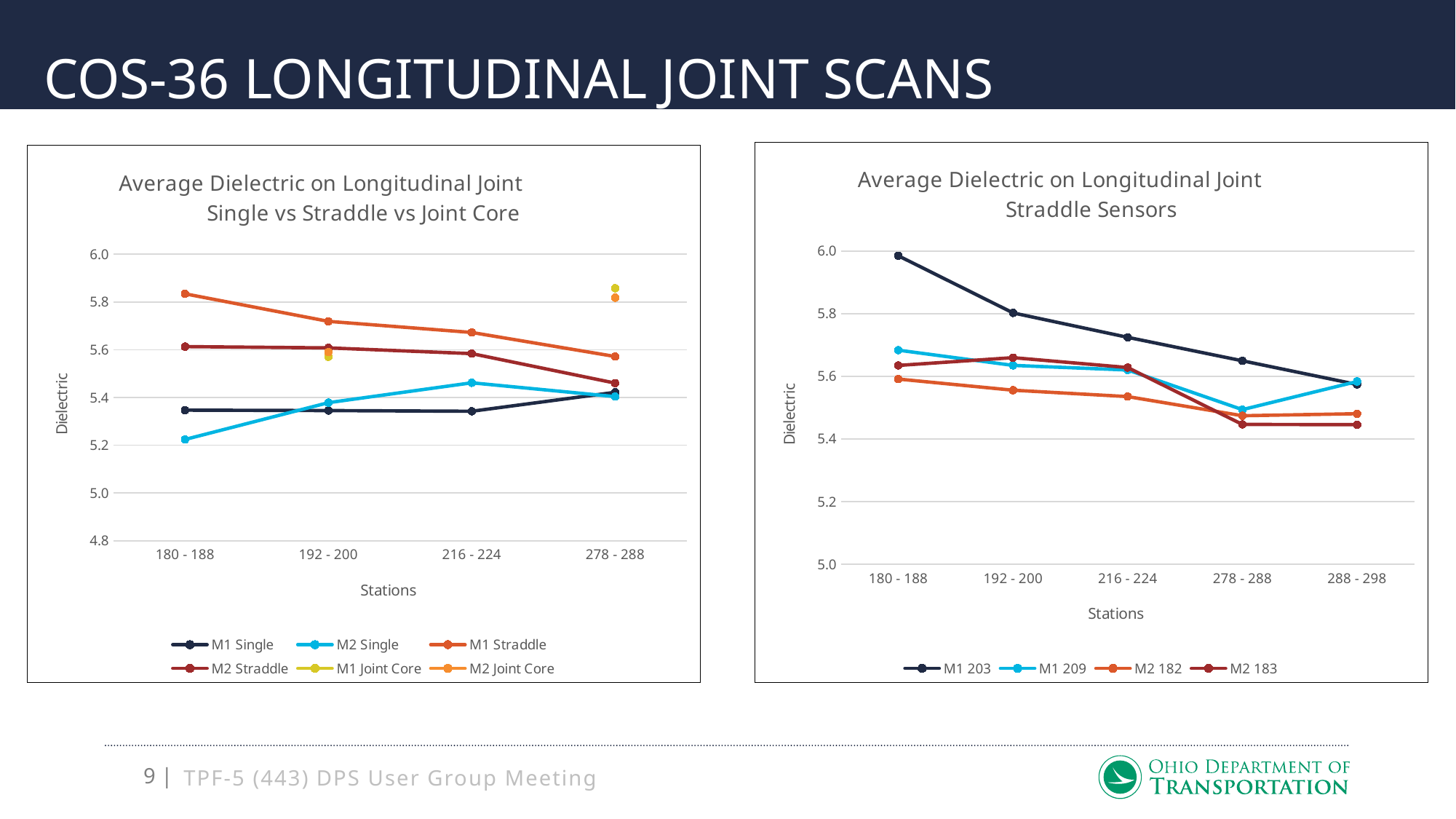
In the left chart, 'Single vs Straddle vs Joint Core', is the value for M2 Single at station 180 - 188 greater or less than 5.4? less How many station categories are shown on the x axis of the left chart, 'Single vs Straddle vs Joint Core'? 4 In the left chart, 'Single vs Straddle vs Joint Core', which series has the lowest value at station 180 - 188? M2 Single In the left chart, 'Single vs Straddle vs Joint Core', which series has the highest value at station 180 - 188? M1 Straddle In the right chart, 'Straddle Sensors', is the value for M1 203 at station 180 - 188 greater or less than 5.8? greater How many series does the legend of the left chart, 'Single vs Straddle vs Joint Core', list? 6 How many series does the legend of the right chart, 'Straddle Sensors', list? 4 What type of chart is the left chart, 'Average Dielectric on Longitudinal Joint Single vs Straddle vs Joint Core'? Line chart In the left chart, 'Single vs Straddle vs Joint Core', does the M1 Straddle series rise or fall from station 180 - 188 to station 278 - 288? Fall How many station categories are shown on the x axis of the right chart, 'Straddle Sensors'? 5 In the right chart, 'Straddle Sensors', which series has the highest value at station 180 - 188? M1 203 In the right chart, 'Straddle Sensors', which is larger at station 192 - 200: M1 203 or M2 182? M1 203